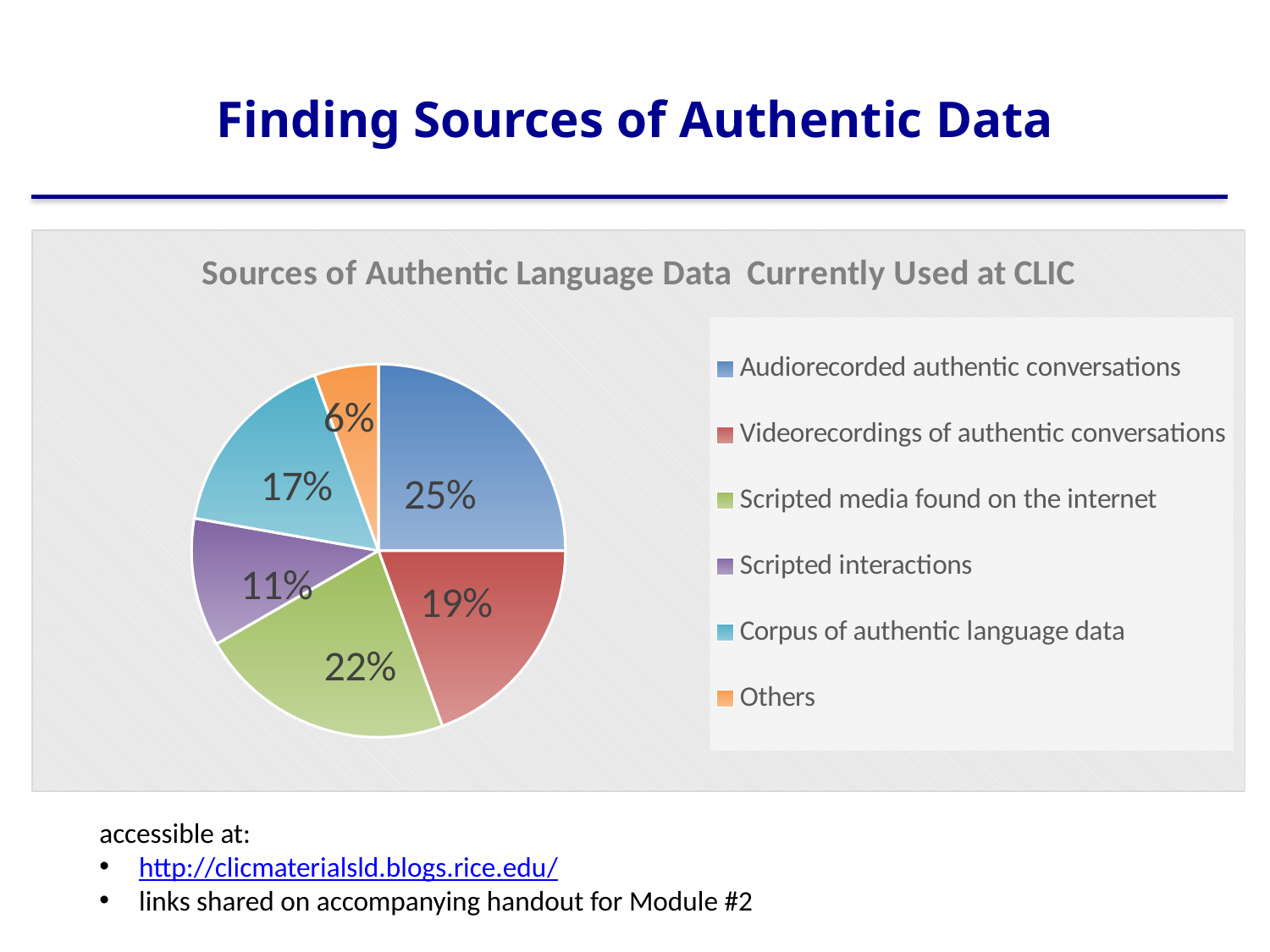
What is the difference in percentage points between Scripted media found on the internet and Scripted interactions? 11% Which category has the largest slice of the pie? Audiorecorded authentic conversations What share of the pie is Audiorecorded authentic conversations? 25% What type of chart is shown on the slide? pie chart What share of the pie is Others? 6% Which category has the smallest slice of the pie? Others What share of the pie is Corpus of authentic language data? 17% How many categories does the legend list? 6 What is the chart's title? Sources of Authentic Language Data Currently Used at CLIC